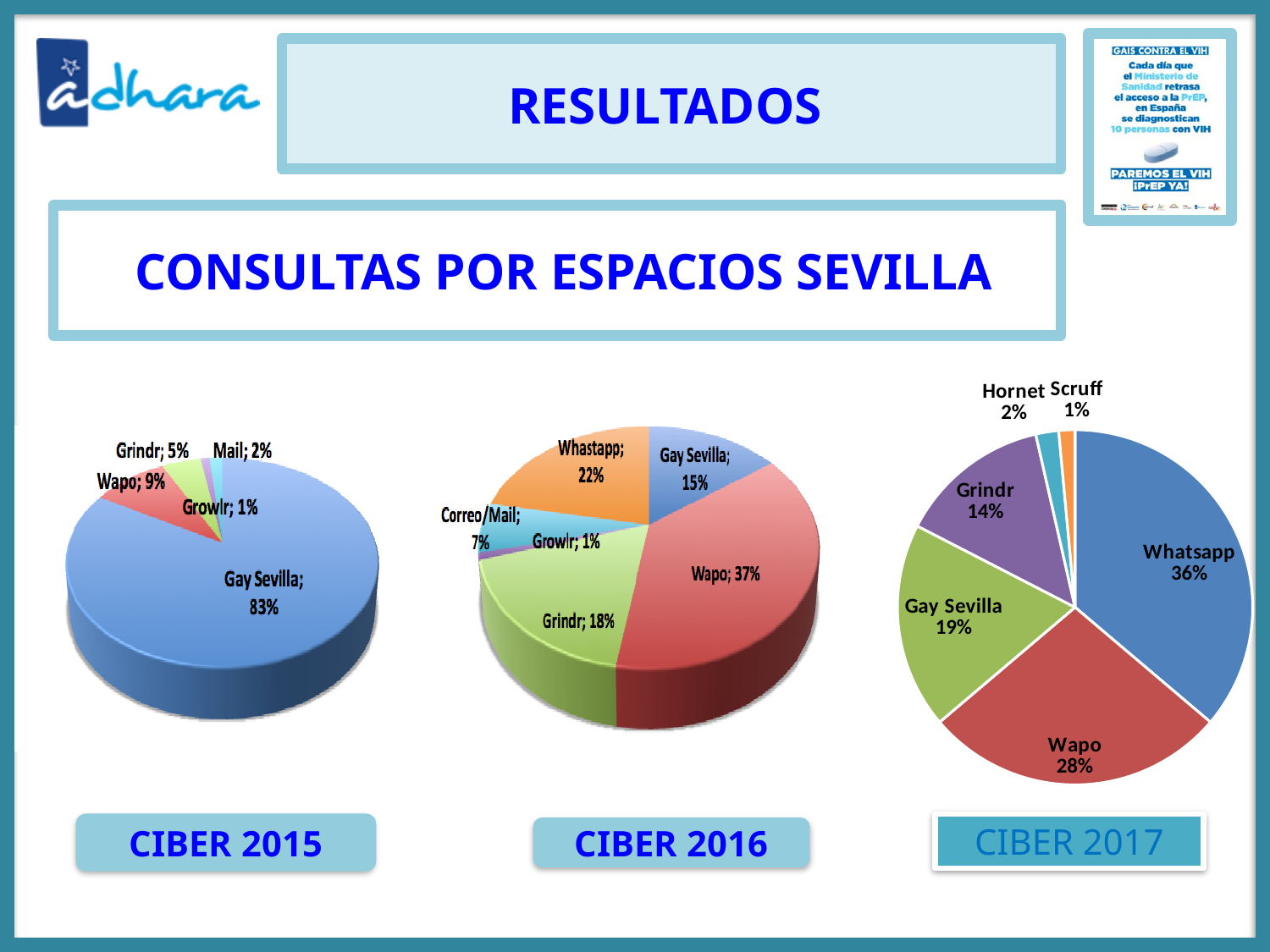
In the CIBER 2016 chart, which is larger, Whastapp or Gay Sevilla? Whastapp In the CIBER 2015 chart, what is the value for Wapo? 9% In the CIBER 2016 chart, which category has the largest share? Wapo How many slices does the CIBER 2015 chart have? 5 What kind of chart is the CIBER 2017 chart? Pie chart In the CIBER 2016 chart, what is the value for Grindr? 18% In the CIBER 2017 chart, what share does Whatsapp have? 36% In the CIBER 2015 chart, what share does Gay Sevilla have? 83% In the CIBER 2016 chart, which category has the smallest share? Growlr How many slices does the CIBER 2017 chart have? 6 In the CIBER 2017 chart, what is the difference between Whatsapp and Wapo? 8% In the CIBER 2017 chart, which category has the smallest share? Scruff